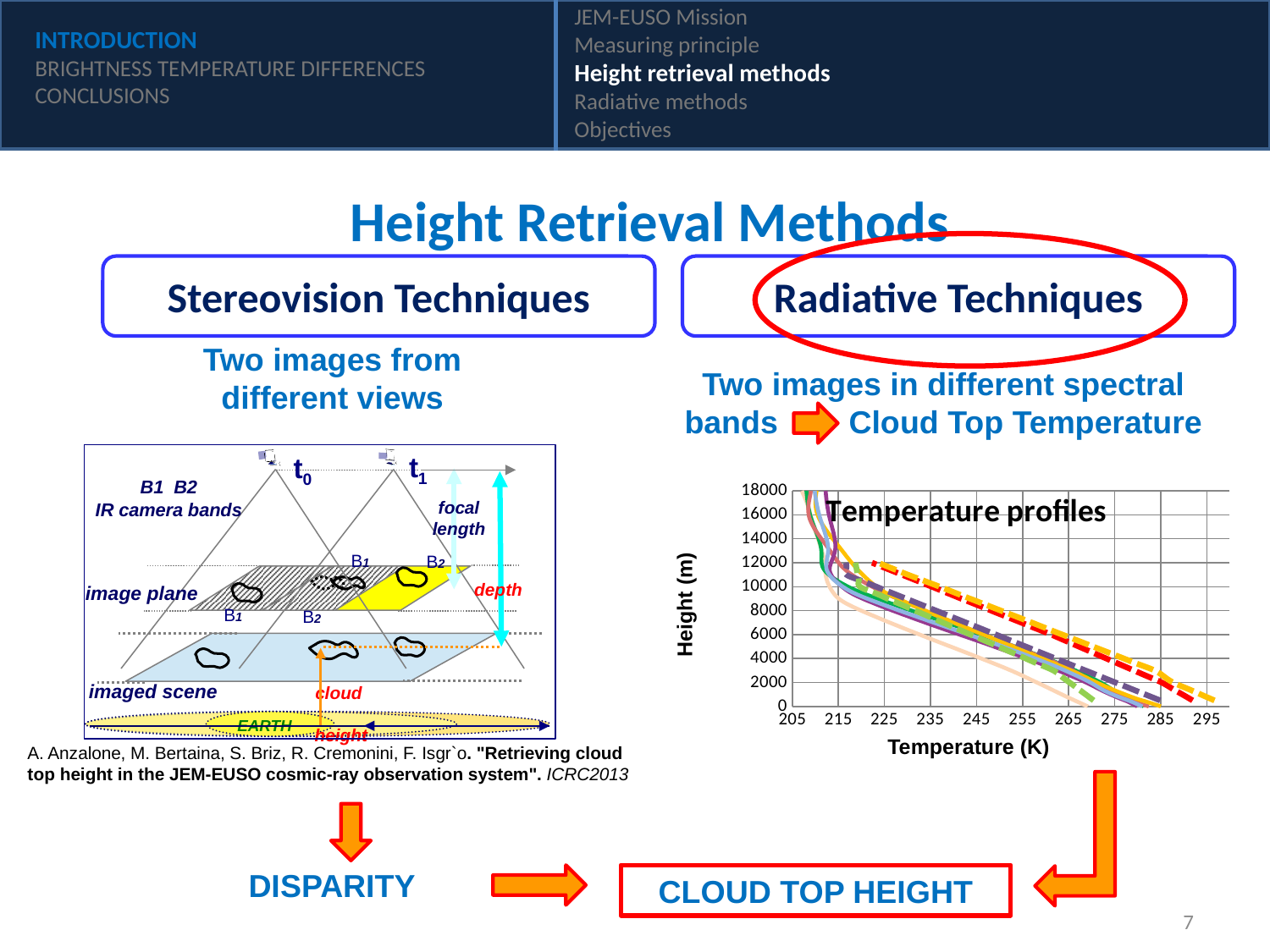
What kind of chart is the "Temperature profiles" chart? line chart What is the title of the chart on the right side of the slide? Temperature profiles In the "Temperature profiles" chart, is the highest temperature reached by any profile greater or less than 285 K? greater In the "Temperature profiles" chart, is the height at which the profiles reach 255 K greater or less than 14000 m? less In the "Temperature profiles" chart, do the profiles rise or fall in height as temperature increases along the x axis? fall In the "Temperature profiles" chart, what are the labels of the x axis and the y axis? Temperature (K) and Height (m)